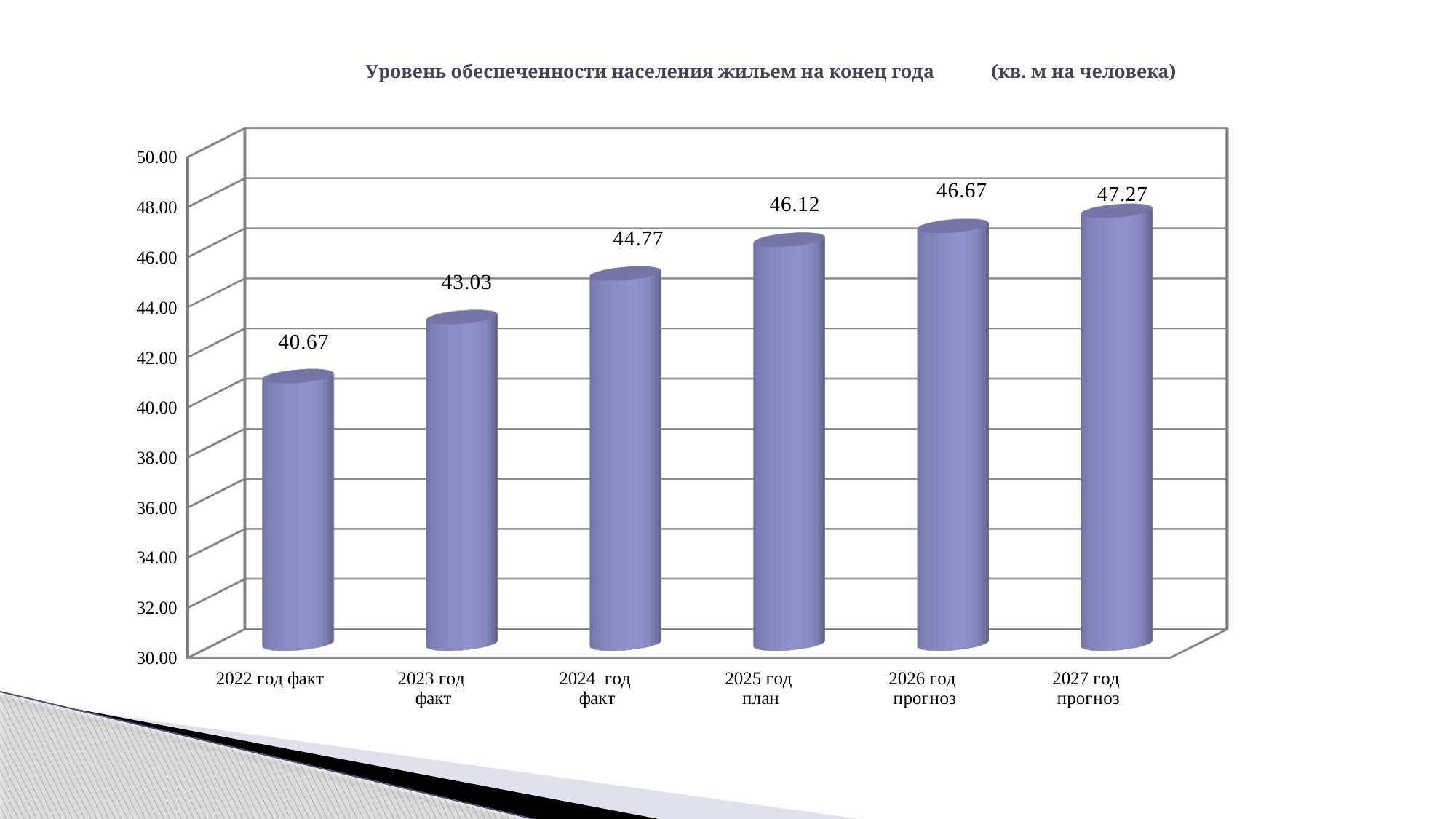
What is the difference between the values for 2027 год прогноз and 2022 год факт? 6.60 What is the value for 2022 год факт? 40.67 What is the difference between the values for 2025 год план and 2024 год факт? 1.35 What is the value for 2025 год план? 46.12 How many categories are shown on the x axis? 6 Which is larger, the value for 2023 год факт or the value for 2026 год прогноз? 2026 год прогноз What kind of chart is shown on the slide? bar chart Is the value for 2024 год факт greater or less than 44.00? greater Do the values rise or fall from 2022 год факт to 2027 год прогноз? rise Which category has the highest value? 2027 год прогноз What is the value for 2027 год прогноз? 47.27 Which category has the lowest value? 2022 год факт